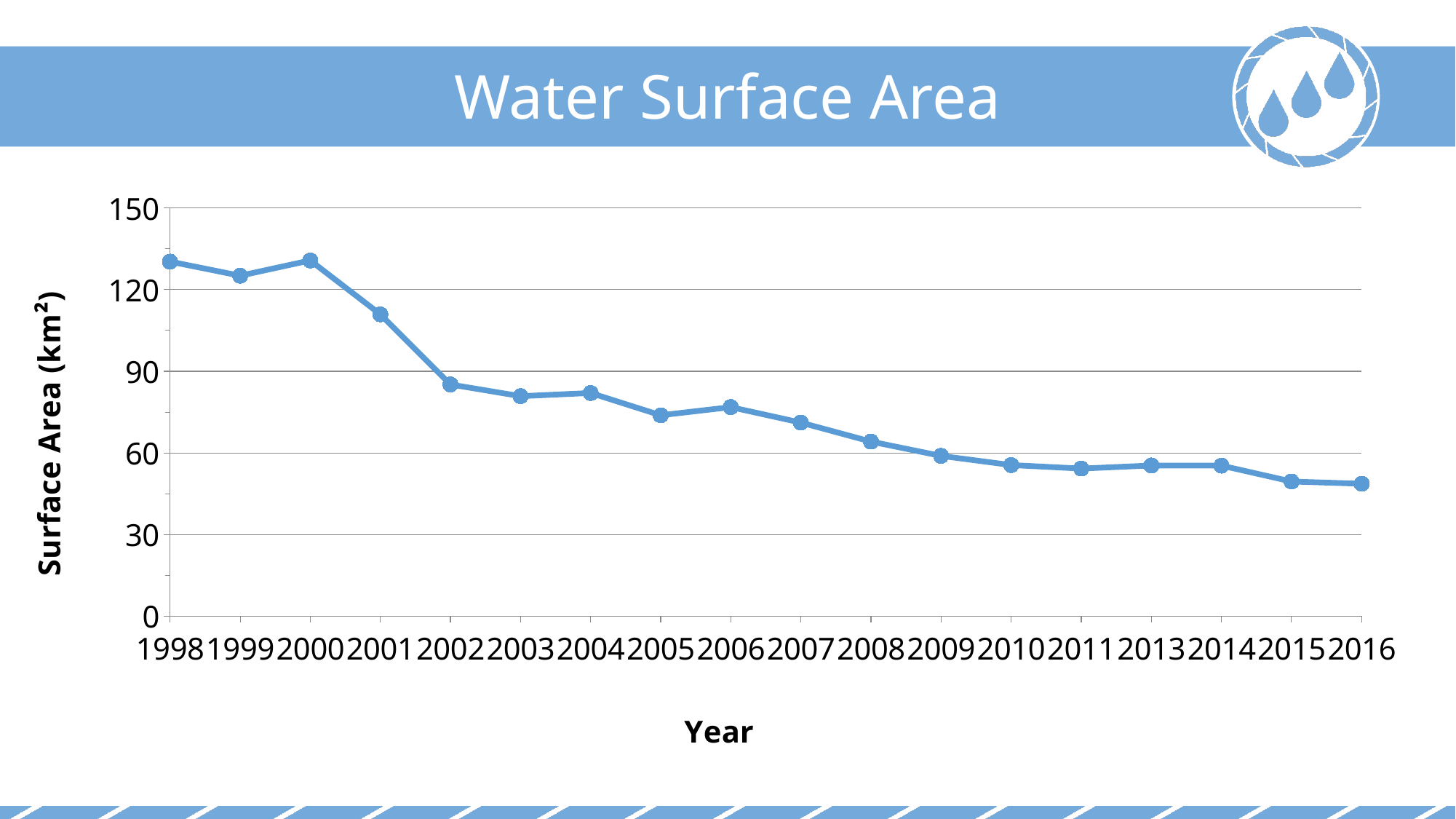
Is the value for 1998 greater or less than 120? greater Which year has the larger value, 1998 or 2016? 1998 How many data points (years) are plotted on the chart? 18 What is the label on the vertical axis? Surface Area (km²) What is the title of the chart? Water Surface Area Which year has the larger value, 2001 or 2002? 2001 Is the value for 2002 greater or less than 90? less Overall, do the values rise or fall from 1998 to 2016? fall Is the value for 2008 greater or less than 60? greater What kind of chart is shown on the slide? line chart